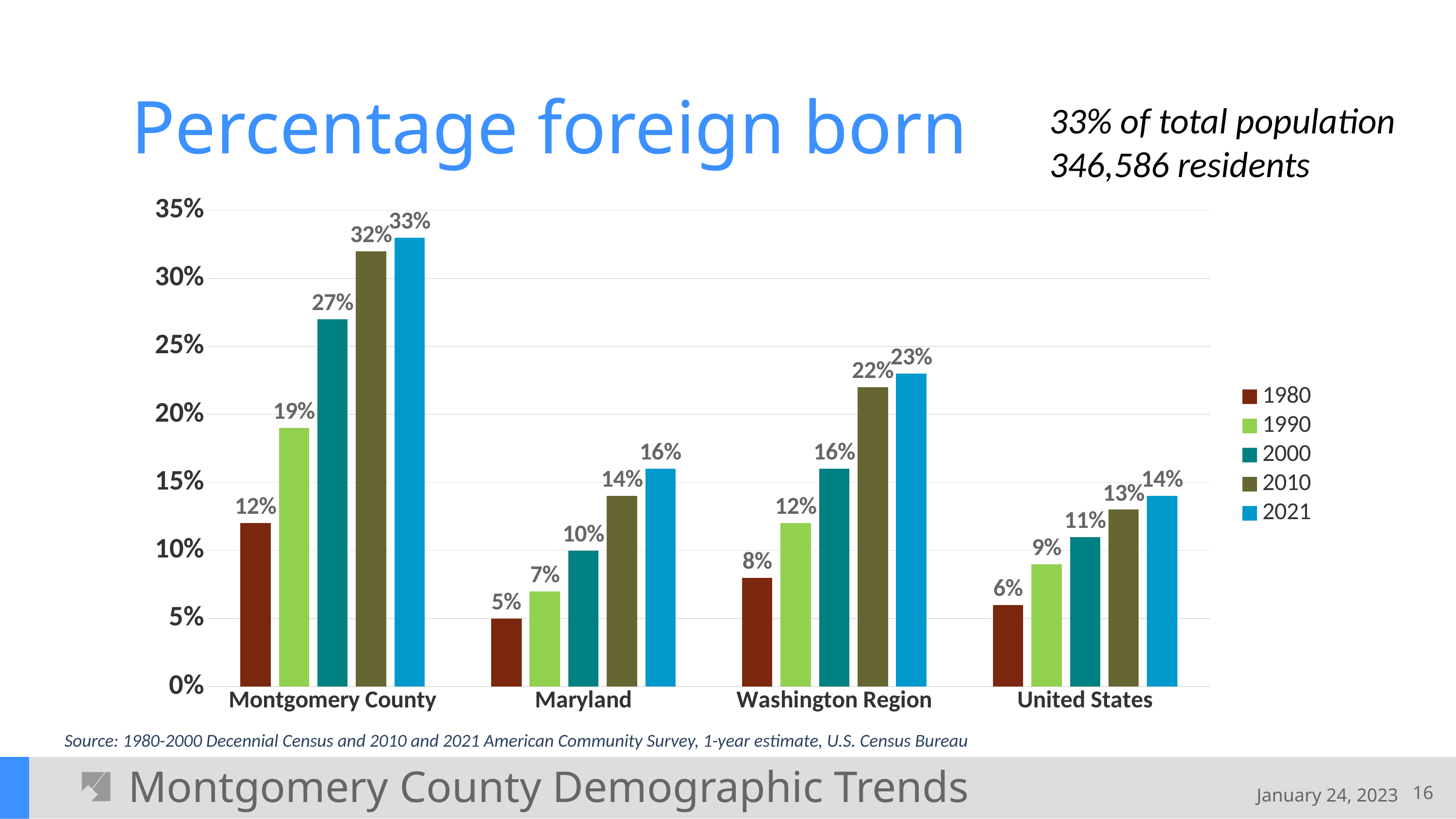
Do the values for the United States rise or fall from 1980 to 2021? Rise What is the percentage foreign born for the United States in 2010? 13% What is the difference between Montgomery County's 2021 value and its 1980 value? 21% What kind of chart is shown on the slide? Bar chart Which category has the lowest percentage foreign born in 1980? Maryland Which category has the highest percentage foreign born in 2021? Montgomery County What is the percentage foreign born for Maryland in 1980? 5% How many categories are shown on the x axis? 4 How many series does the legend list? 5 Which is larger: the 2010 value for the Washington Region or the 2010 value for Maryland? Washington Region What is the percentage foreign born for the Washington Region in 2000? 16% What is the percentage foreign born for Montgomery County in 2021? 33%